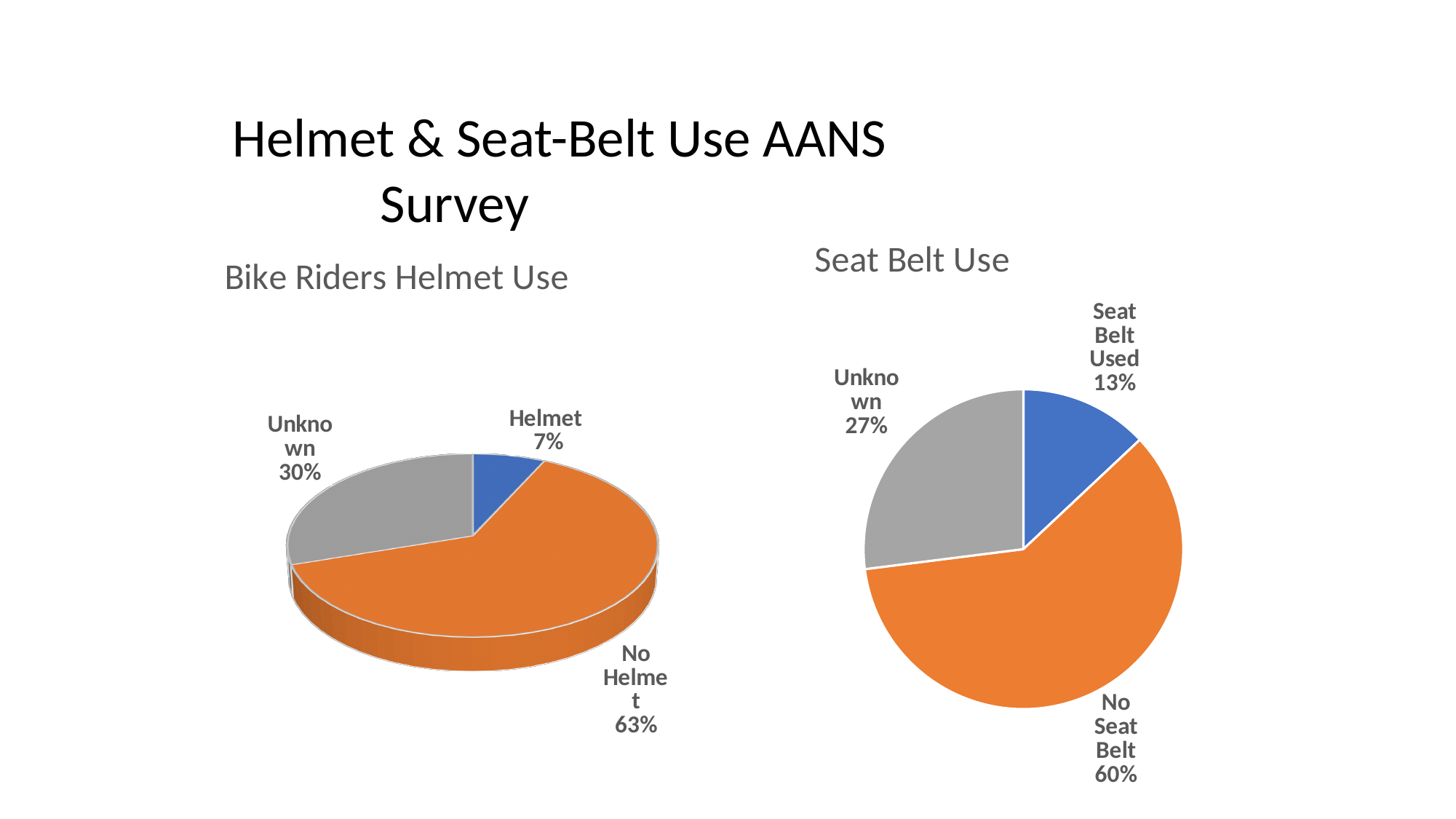
In the 'Bike Riders Helmet Use' chart, what percentage of riders wore a helmet? 7% In the 'Seat Belt Use' chart, which category has the smallest slice? Seat Belt Used In the 'Seat Belt Use' chart, what is the share for Unknown? 27% In the 'Seat Belt Use' chart, what is the share for No Seat Belt? 60% In the 'Bike Riders Helmet Use' chart, which is larger: Unknown or Helmet? Unknown How many slices does the 'Seat Belt Use' chart have? 3 In the 'Seat Belt Use' chart, what is the difference between the No Seat Belt and Unknown shares? 33% In the 'Bike Riders Helmet Use' chart, what is the share for No Helmet? 63% What type of chart is the 'Bike Riders Helmet Use' chart? Pie chart In the 'Bike Riders Helmet Use' chart, what is the share for Unknown? 30% In the 'Bike Riders Helmet Use' chart, which category has the largest slice? No Helmet In the 'Seat Belt Use' chart, what percentage is labelled Seat Belt Used? 13%